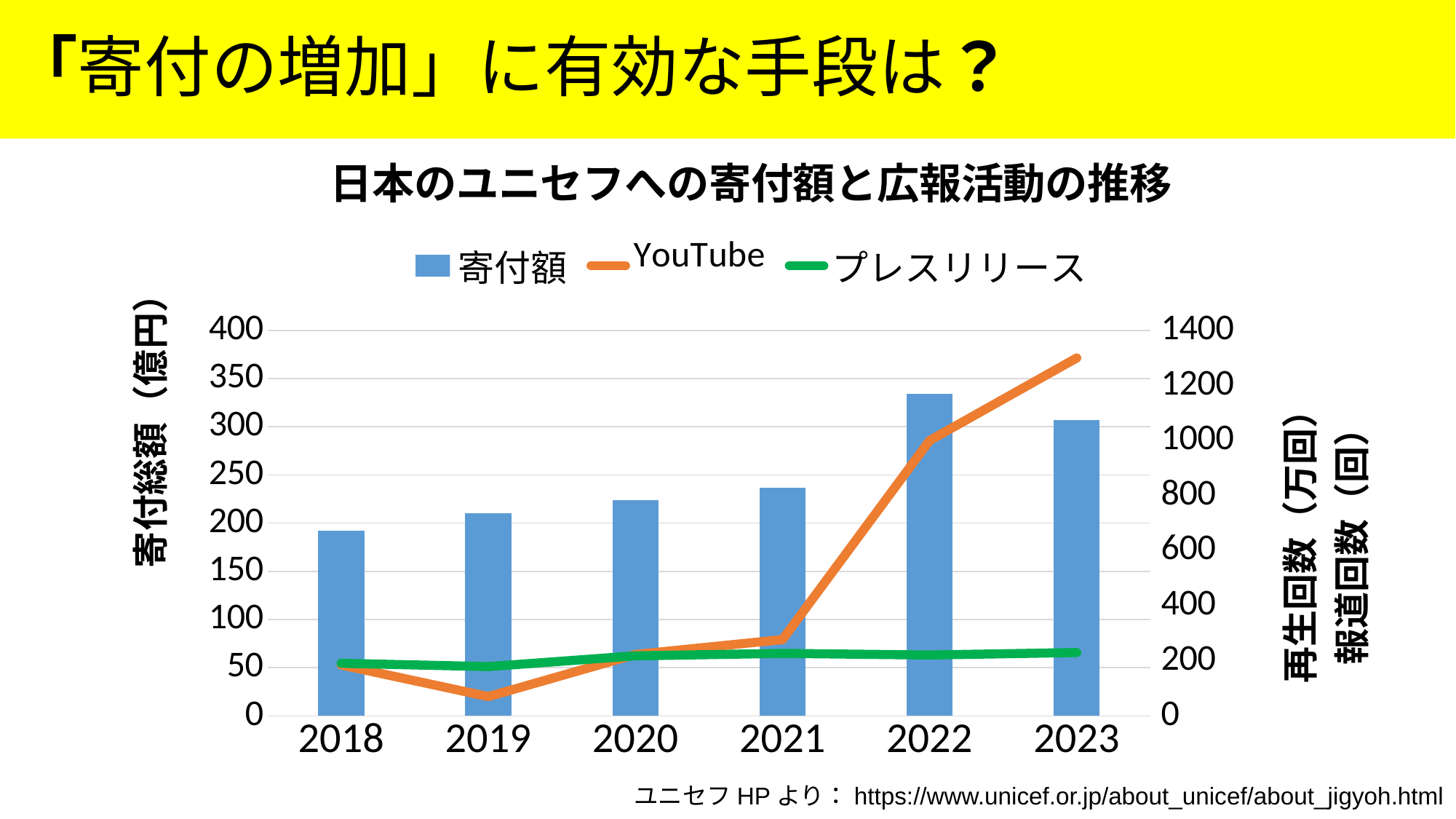
Which is larger in 2022, the YouTube value or the プレスリリース value? YouTube Is the YouTube value for 2023 greater or less than 1200? greater Is the 寄付額 value for 2022 greater or less than 300? greater How many years are shown on the x axis? 6 How many series does the legend list? 3 Which year has the highest 寄付額 bar? 2022 Does the YouTube line rise or fall from 2021 to 2023? Rise What kind of chart is shown on the slide? A combined bar and line chart In which year is the YouTube line at its lowest? 2019 What colour is the プレスリリース line? Green Which year has the lowest 寄付額 bar? 2018 Is the 寄付額 value for 2018 greater or less than 200? less